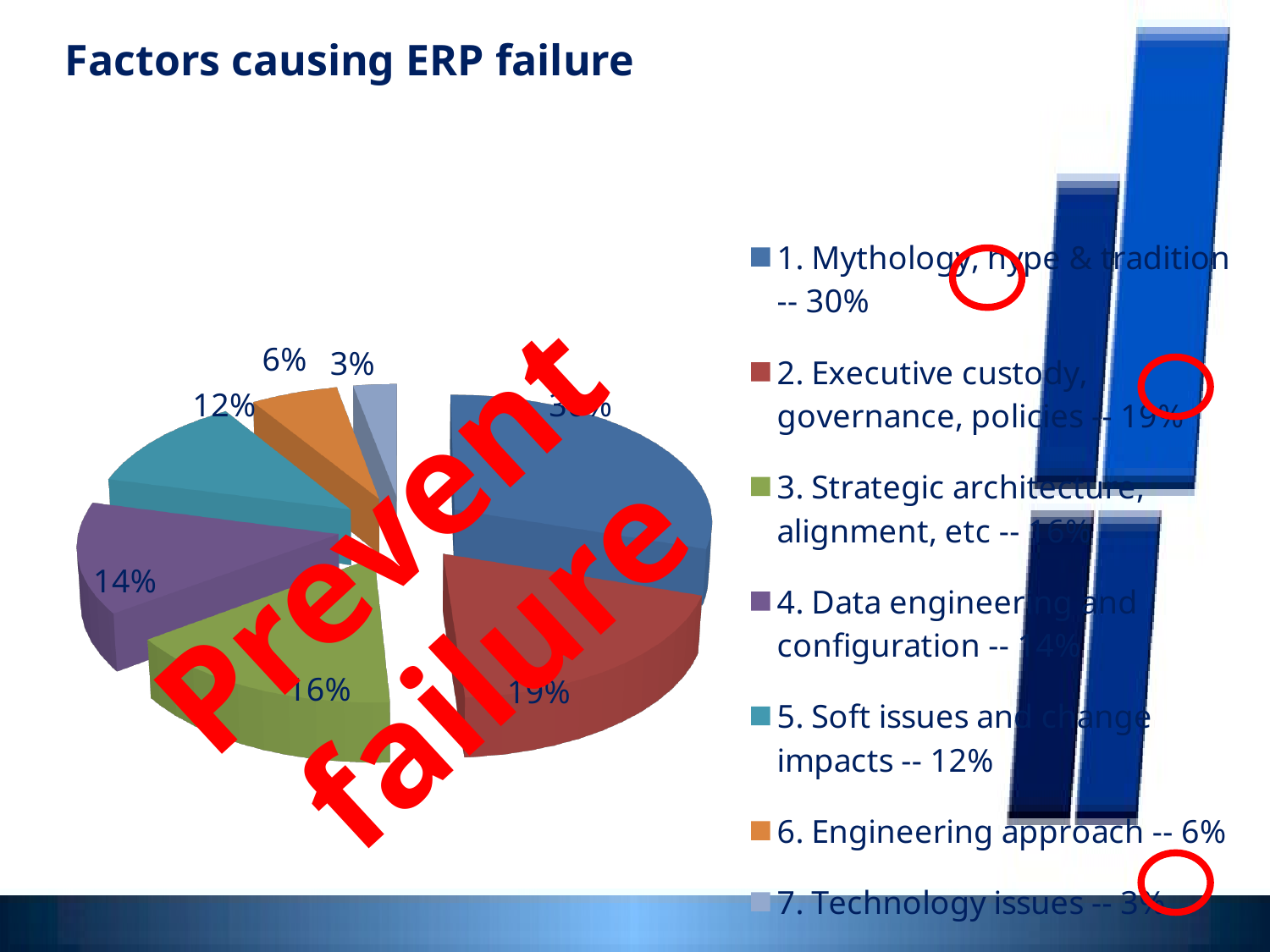
What kind of chart is shown on the slide? pie chart What percentage is shown for "Data engineering and configuration"? 14% How many slices does the pie chart have? 7 What share of the pie does "Technology issues" represent? 3% What is the title of the slide containing the pie chart? Factors causing ERP failure What is the difference in percentage points between "Mythology, hype & tradition" and "Executive custody, governance, policies"? 11 Which factor has the largest share of the pie? 1. Mythology, hype & tradition Which factor has the smallest share of the pie? 7. Technology issues What percentage is shown for "Executive custody, governance, policies"? 19% Which is larger: the share for "Strategic architecture, alignment, etc" or the share for "Data engineering and configuration"? Strategic architecture, alignment, etc What percentage is shown for "Engineering approach"? 6% What percentage is shown for "Soft issues and change impacts"? 12%